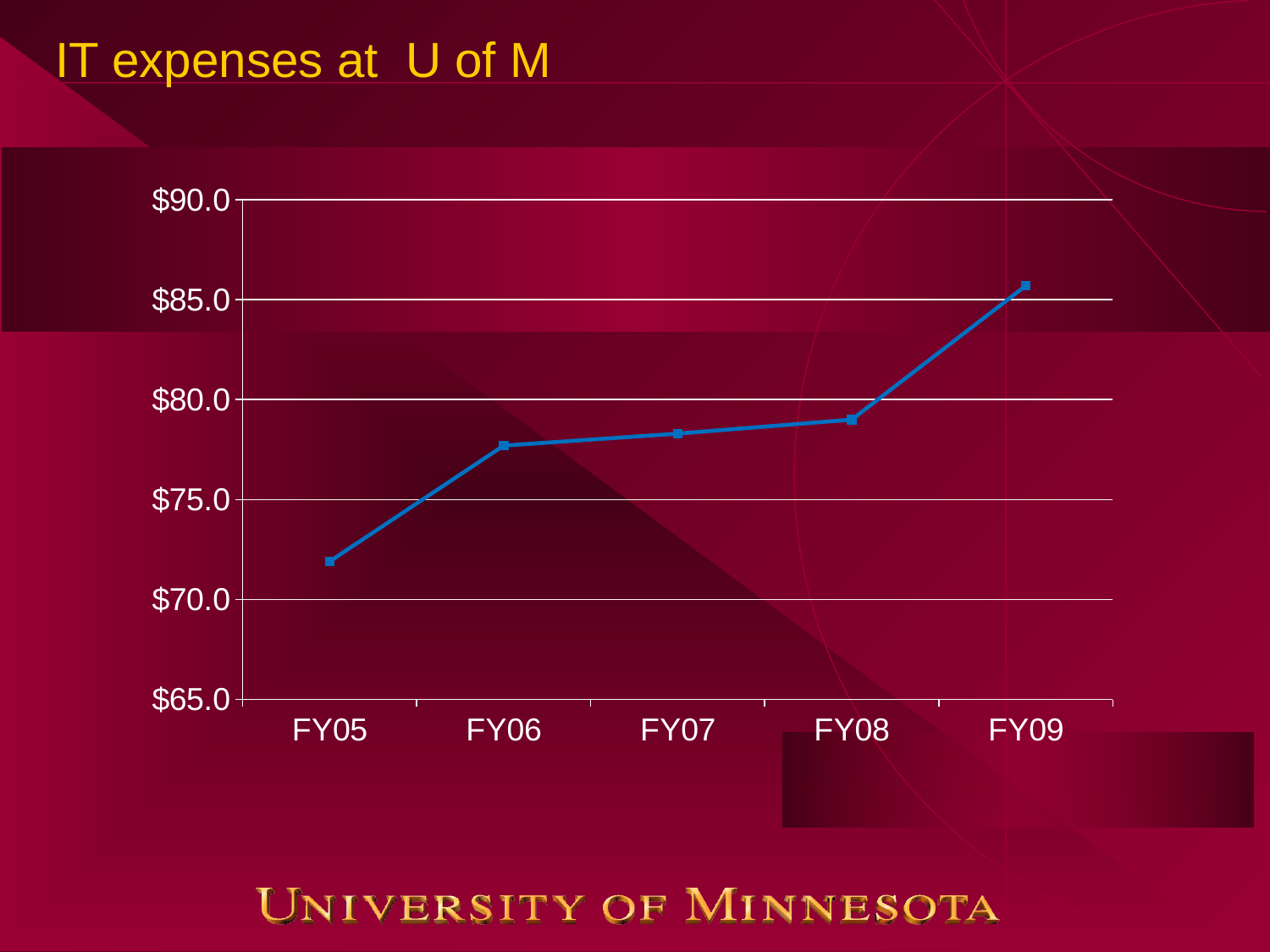
Which is larger, the value for FY08 or the value for FY09? FY09 Which fiscal year has the lowest IT expenses? FY05 Is the value for FY05 greater or less than $75.0? less What is the title of the chart on the slide? IT expenses at U of M How many fiscal years are plotted on the x axis? 5 Do IT expenses rise or fall from FY05 to FY09? rise Which fiscal year has the highest IT expenses? FY09 Is the value for FY05 greater or less than $70.0? greater Which is larger, the value for FY05 or the value for FY06? FY06 Is the value for FY06 greater or less than $80.0? less What kind of chart is shown on the slide? line chart